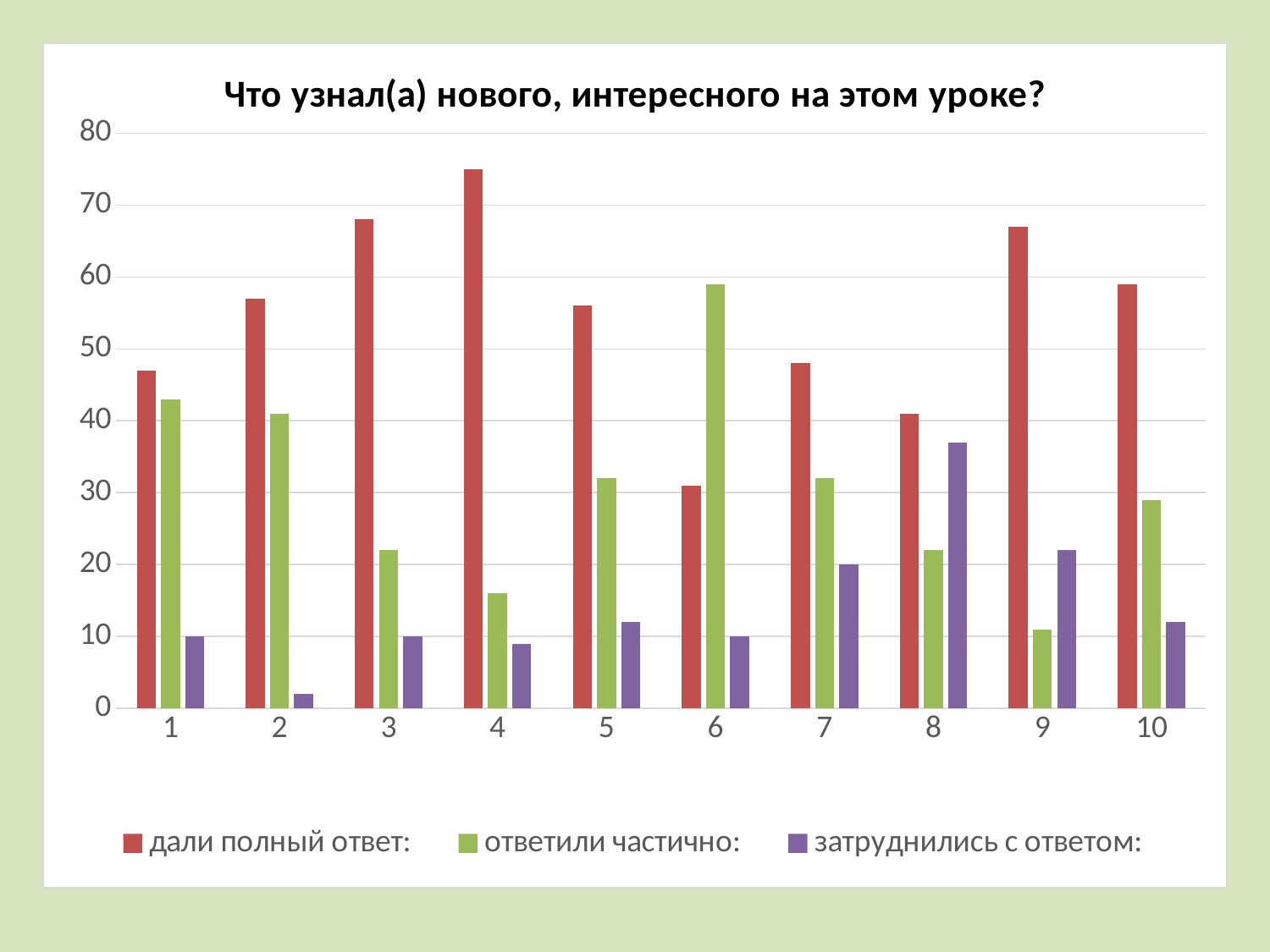
Is the value of 'ответили частично:' for category 9 greater or less than 20? less Is the value of 'дали полный ответ:' for category 4 greater or less than 70? greater What is the title of the chart? Что узнал(а) нового, интересного на этом уроке? For which category is the value of 'затруднились с ответом:' the highest? 8 For which category is the value of 'дали полный ответ:' the highest? 4 For which category is the value of 'дали полный ответ:' the lowest? 6 How many categories are shown on the x axis? 10 For which category is the value of 'ответили частично:' the highest? 6 What kind of chart is shown on the slide? bar chart For which category is the value of 'затруднились с ответом:' the lowest? 2 How many series does the legend list? 3 In category 6, which series has the larger value: 'дали полный ответ:' or 'ответили частично:'? ответили частично: